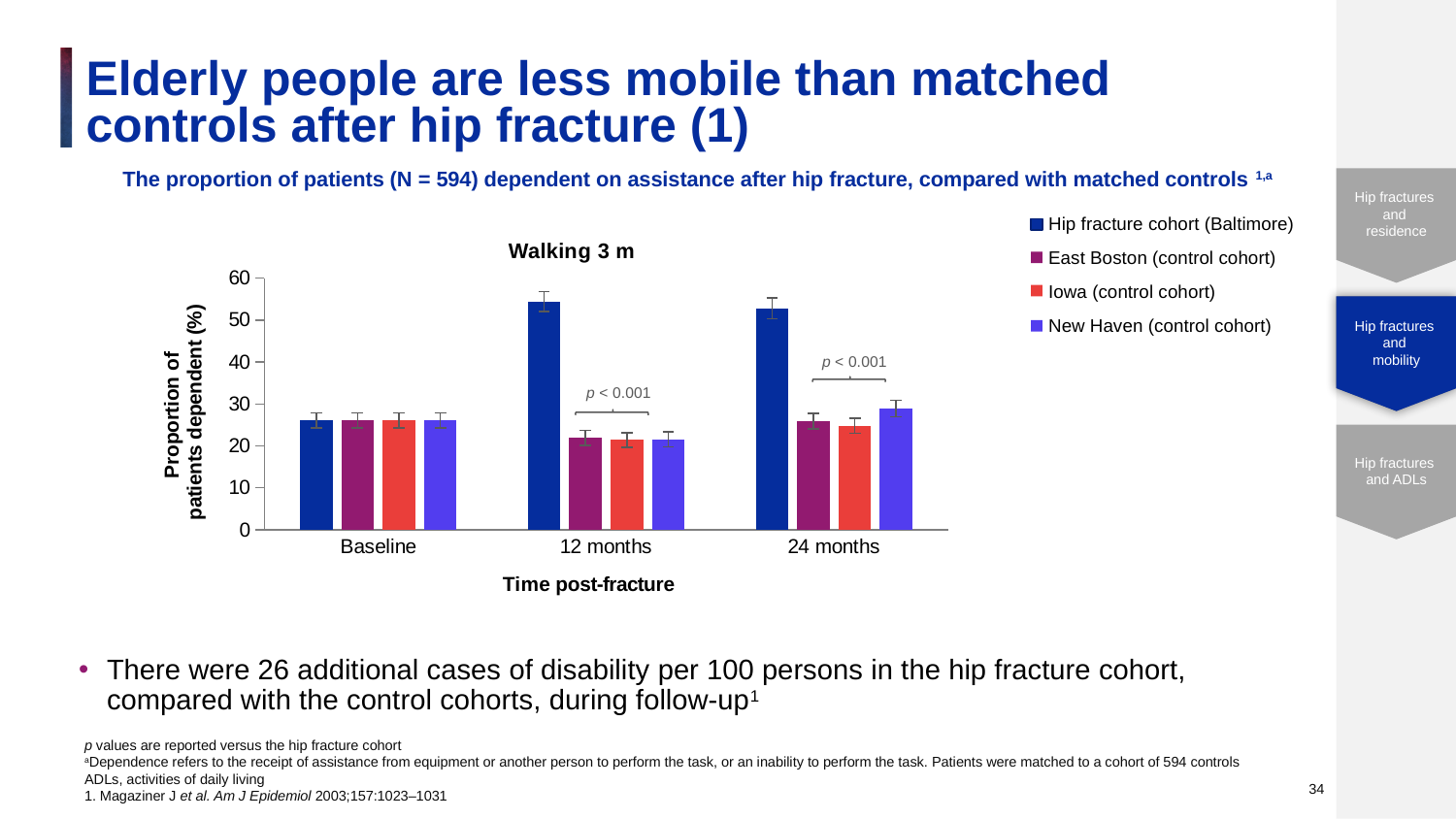
Is the value for the Hip fracture cohort (Baltimore) at 12 months greater or less than 50? greater Is the value for the Hip fracture cohort (Baltimore) at 24 months greater or less than 40? greater What is the title of the chart? Walking 3 m How many series does the legend list? 4 How many time-point categories are shown on the x axis? 3 Is the value for the Hip fracture cohort (Baltimore) at Baseline greater or less than 30? less What is the label of the x axis? Time post-fracture Does the value for the Hip fracture cohort (Baltimore) rise or fall from Baseline to 12 months? rise What kind of chart is shown on the slide? Bar chart Which series has the highest value at 12 months? Hip fracture cohort (Baltimore) At 24 months, which is larger: the Hip fracture cohort (Baltimore) or East Boston (control cohort)? Hip fracture cohort (Baltimore)